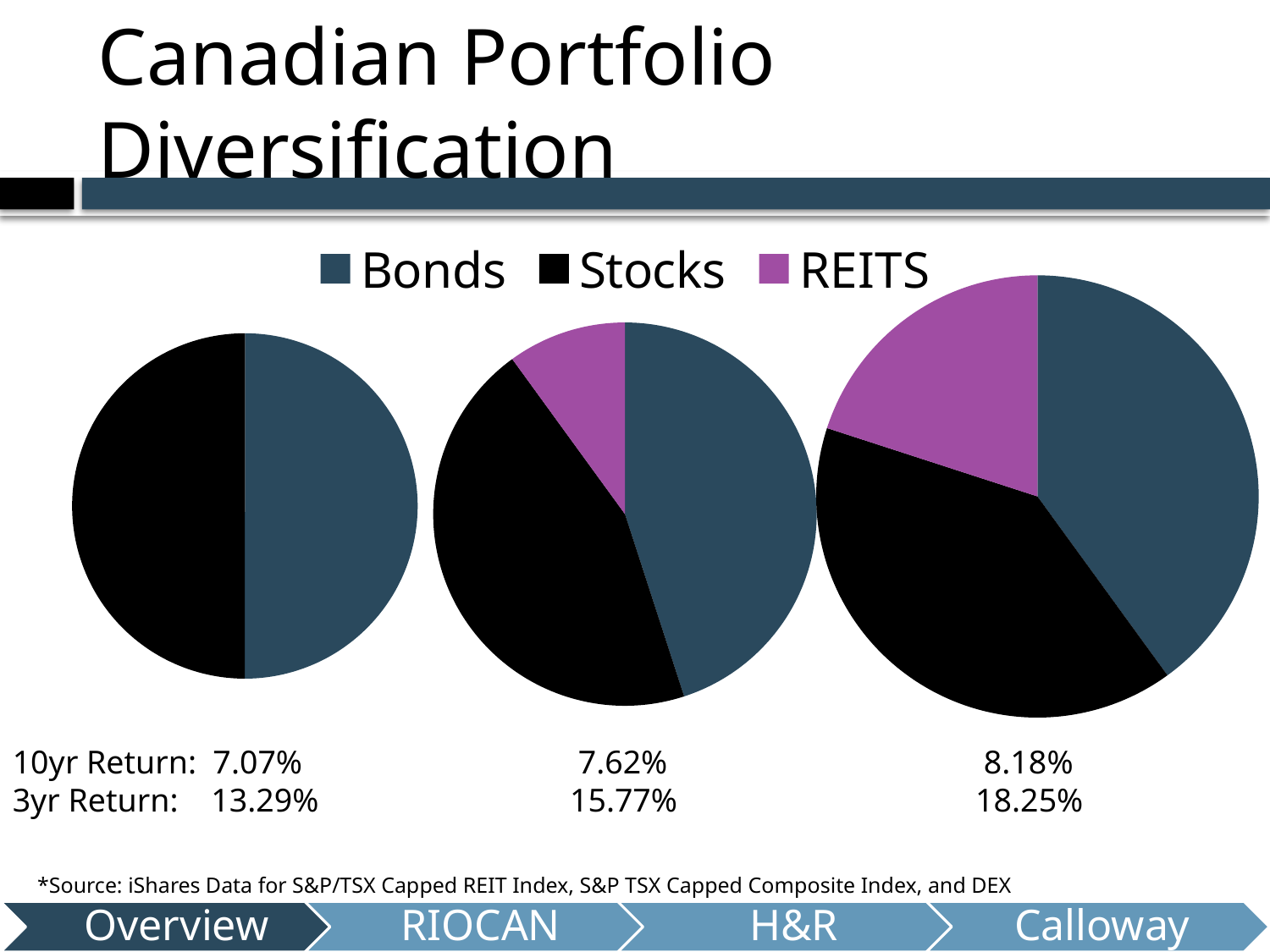
In the middle pie chart, how many slices are there? 3 In the middle pie chart, which category has the smallest slice? REITS What is the 10yr Return shown under the right pie chart? 8.18% In the right pie chart, which category has the smallest slice? REITS How many series does the legend list? 3 In the right pie chart, how many slices are there? 3 How many pie charts are on the slide? 3 What kind of charts are shown on the slide? Pie charts Which category from the legend does not appear in the left pie chart? REITS Which three categories are listed in the legend? Bonds, Stocks, REITS Which pie chart has the larger REITS slice, the middle one or the right one? The right one